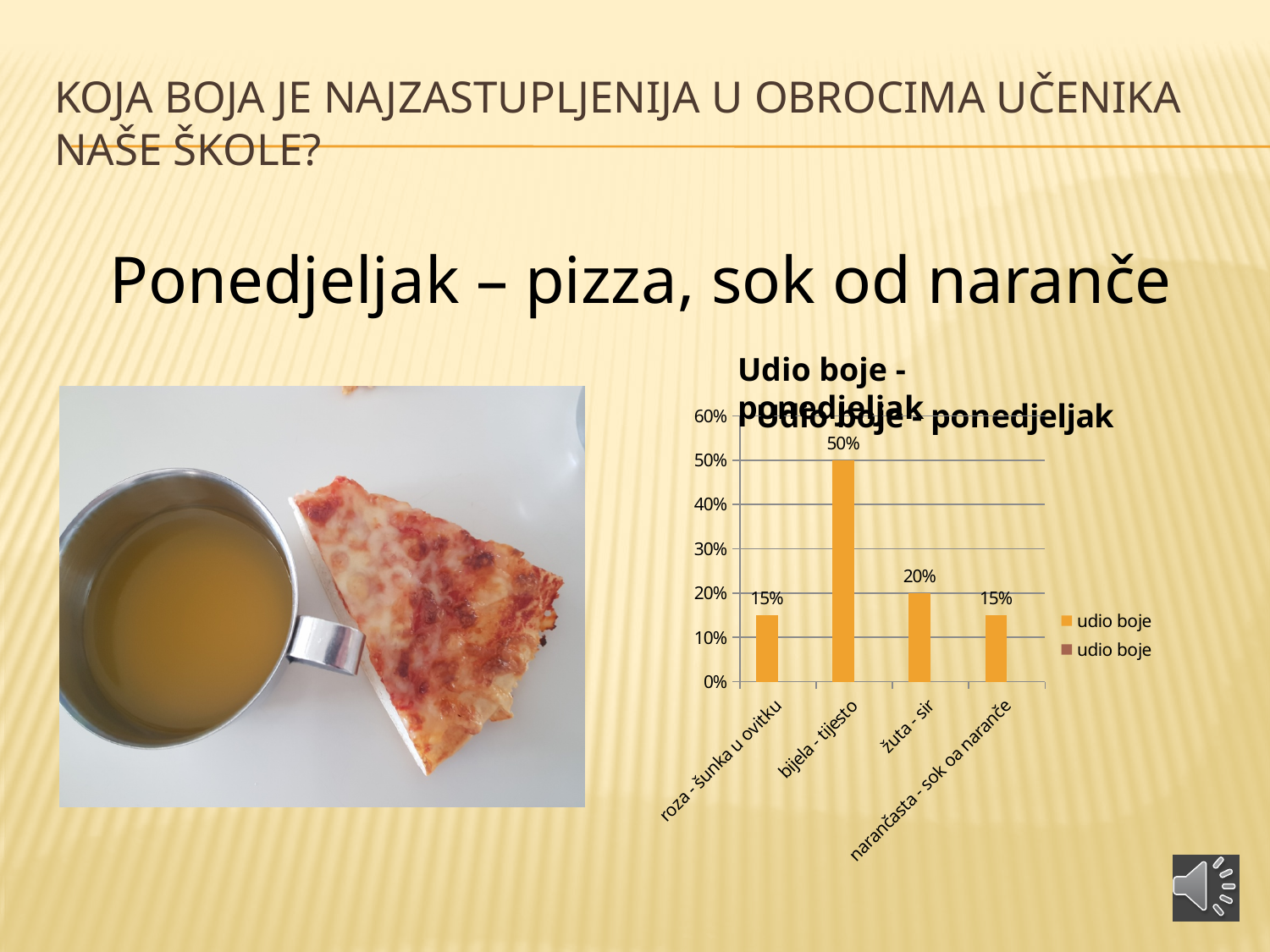
What is the difference between the values for "žuta - sir" and "roza - šunka u ovitku"? 5% What is the value for "roza - šunka u ovitku"? 15% Which is larger, the value for "bijela - tijesto" or the value for "žuta - sir"? bijela - tijesto What is the value for "narančasta - sok od naranče"? 15% What is the title of the chart? Udio boje - ponedjeljak What is the value for "žuta - sir"? 20% How many categories are shown on the x axis of the chart? 4 What is the difference between the values for "bijela - tijesto" and "žuta - sir"? 30% What type of chart is shown on the slide? bar chart Which category has the highest value? bijela - tijesto What is the value for "bijela - tijesto"? 50% Is the value for "bijela - tijesto" greater or less than 40%? greater